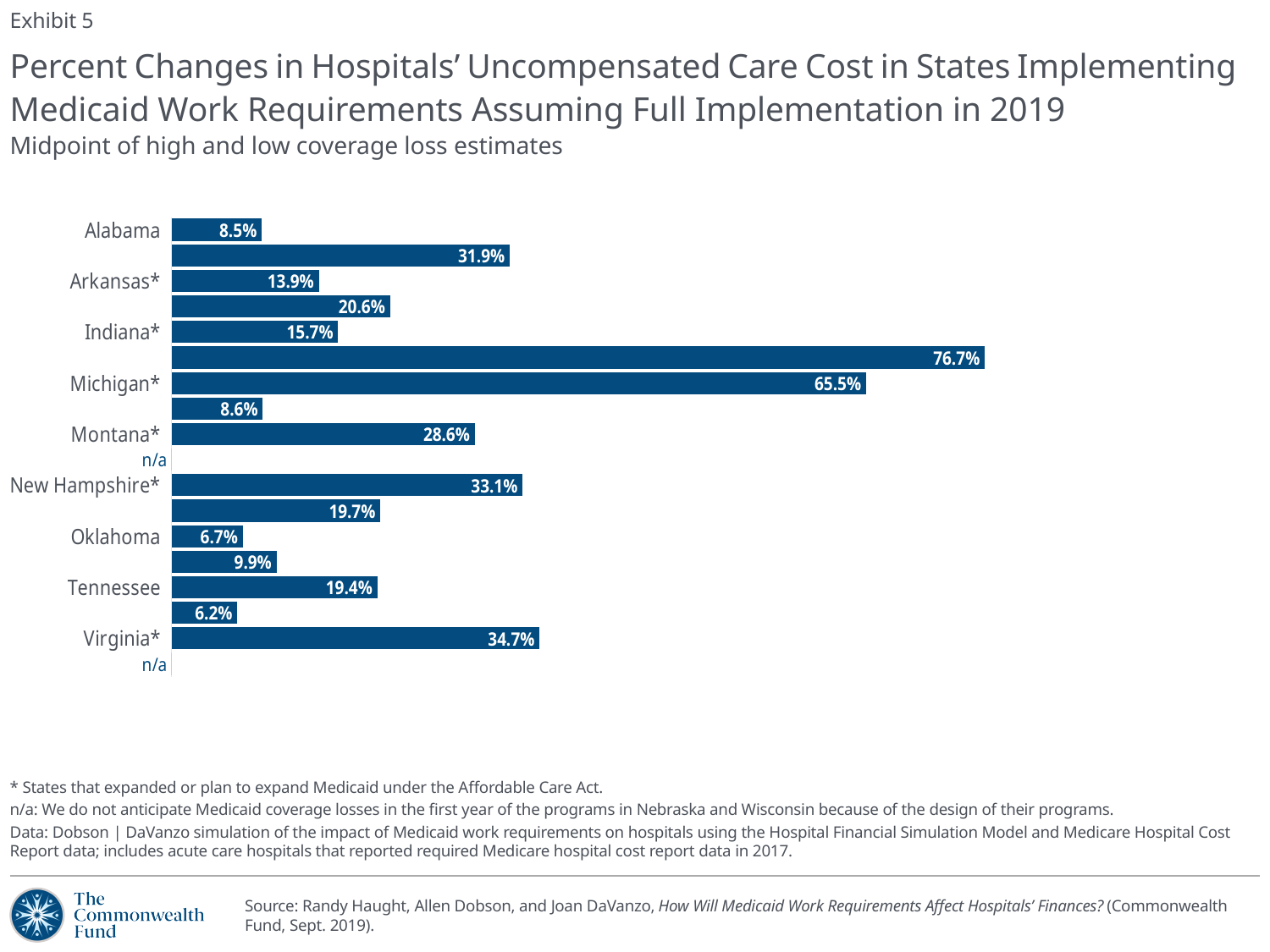
What percent change is shown for Oklahoma? 6.7% What value is shown for Alabama? 8.5% What is the percent change in uncompensated care cost for Michigan*? 65.5% What is the value for New Hampshire*? 33.1% What is the value for Tennessee? 19.4% What kind of chart is shown on the slide? Bar chart Which has the larger value, Arkansas* or Indiana*? Indiana* What is the difference in percentage points between Michigan* and Alabama? 57.0 percentage points Which has the larger value, Montana* or New Hampshire*? New Hampshire* What is the value for Virginia*? 34.7% How many entries in the chart are marked n/a? 2 What is the difference in percentage points between Virginia* and New Hampshire*? 1.6 percentage points